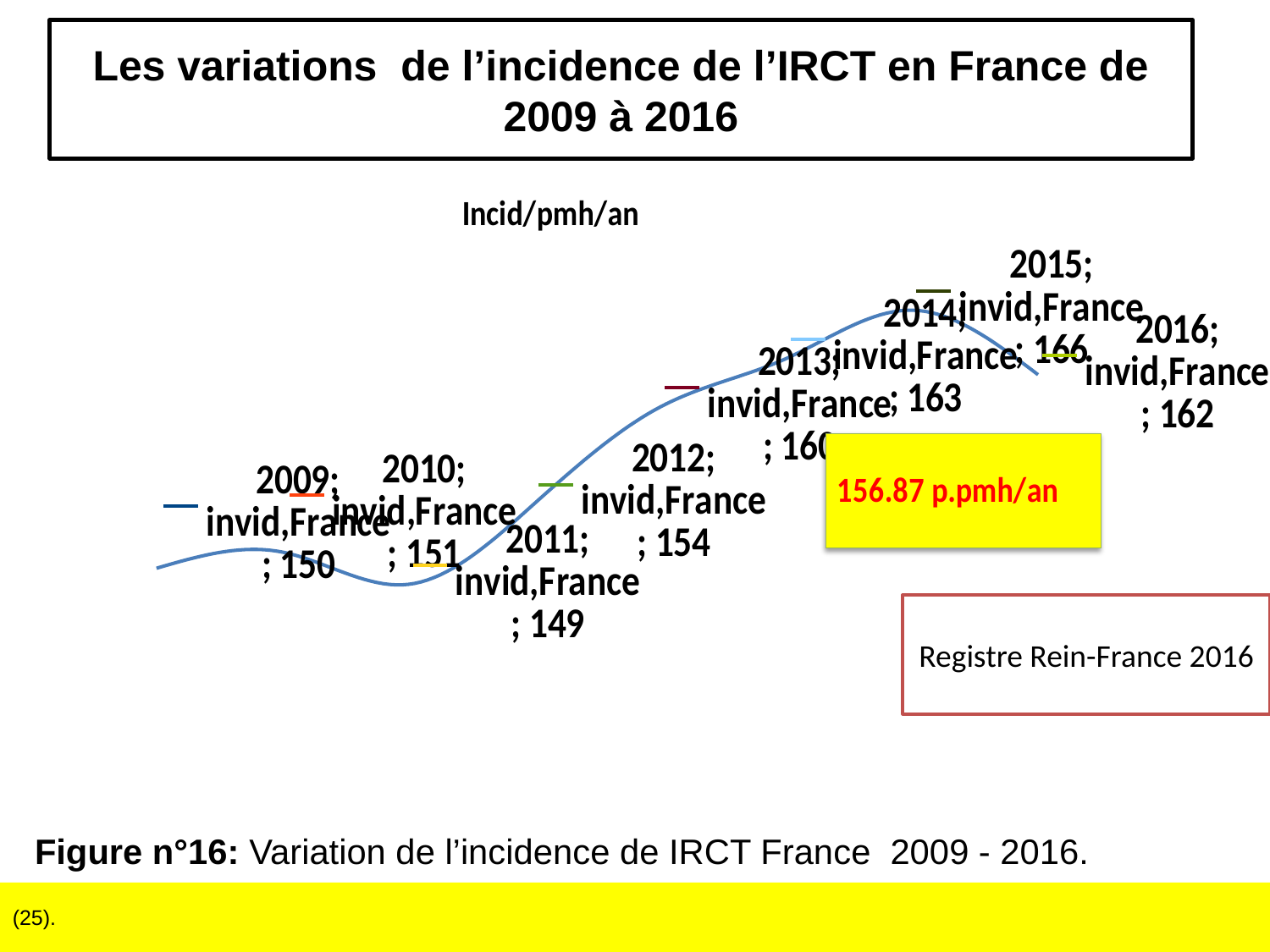
What is the value for 2011 in the chart? 149 What is the difference between the values for 2015 and 2009? 16 Which year has the highest value in the chart? 2015 What is the title of the chart? Incid/pmh/an Which year has the lowest value in the chart? 2011 What is the difference between the values for 2015 and 2016? 4 What kind of chart is shown on the slide? line chart Which is larger, the value for 2014 or the value for 2016? 2014 What is the value for 2016 in the chart? 162 What is the value for 2009 in the chart? 150 What is the value for 2015 in the chart? 166 How many years (data points) are plotted in the chart? 8